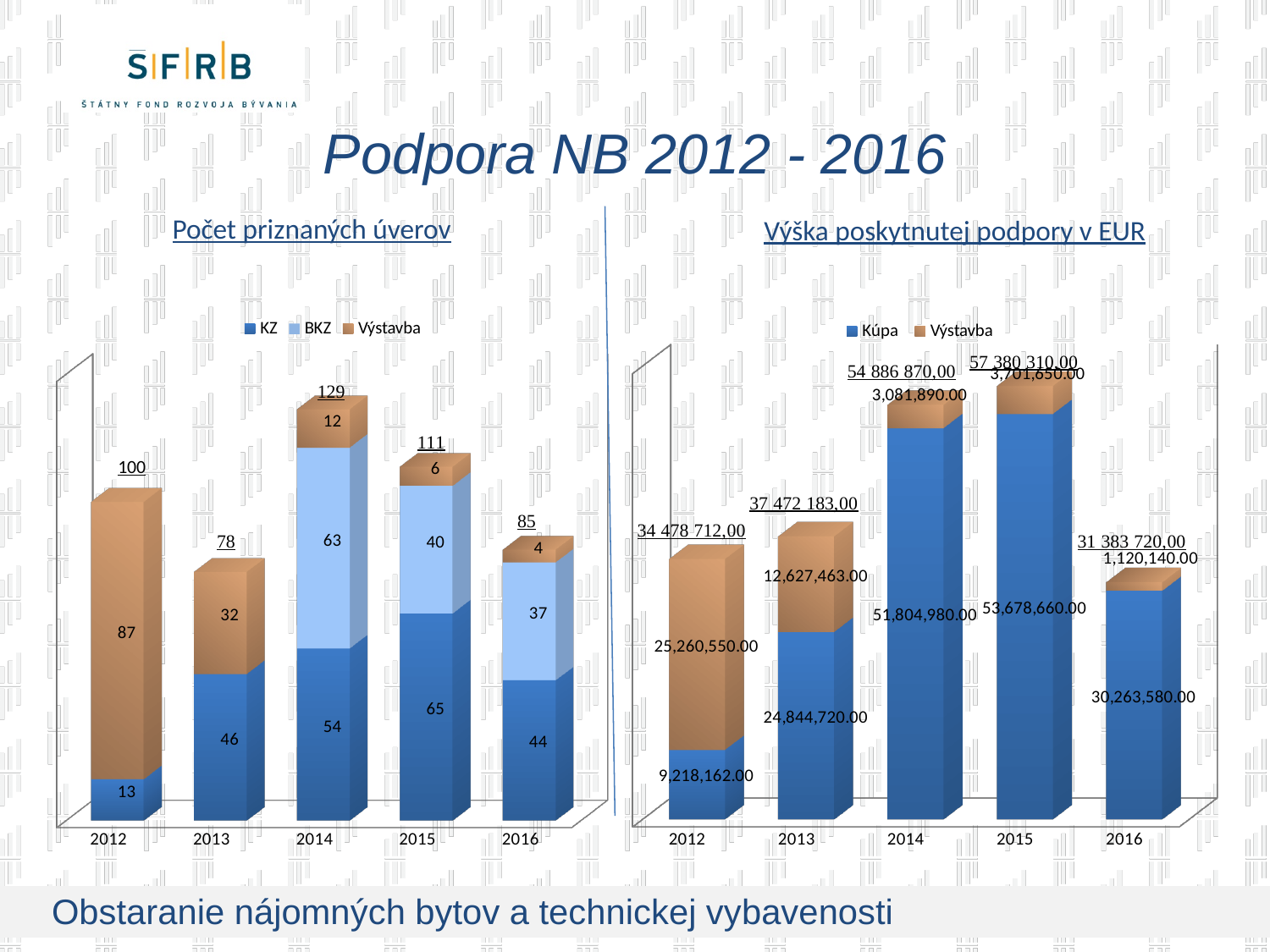
In the 'Počet priznaných úverov' chart, what is the total shown above the 2013 bar? 78 In the 'Výška poskytnutej podpory v EUR' chart, what is the Kúpa value for 2014? 51,804,980.00 What kind of chart is the 'Výška poskytnutej podpory v EUR' chart? Stacked bar chart In the 'Počet priznaných úverov' chart, which year has the highest total number of loans? 2014 How many years are shown on the x axis of the 'Výška poskytnutej podpory v EUR' chart? 5 In the 'Výška poskytnutej podpory v EUR' chart, what is the Výstavba value for 2016? 1,120,140.00 In the 'Počet priznaných úverov' chart, what is the Výstavba value for 2012? 87 In the 'Počet priznaných úverov' chart, what is the difference between the BKZ values for 2014 and 2016? 26 In the 'Počet priznaných úverov' chart, what is the KZ value for 2015? 65 In the 'Výška poskytnutej podpory v EUR' chart, which year has the lowest total support? 2016 In the 'Počet priznaných úverov' chart, how many series does the legend list? 3 In the 'Výška poskytnutej podpory v EUR' chart, which is larger for 2012: Kúpa or Výstavba? Výstavba